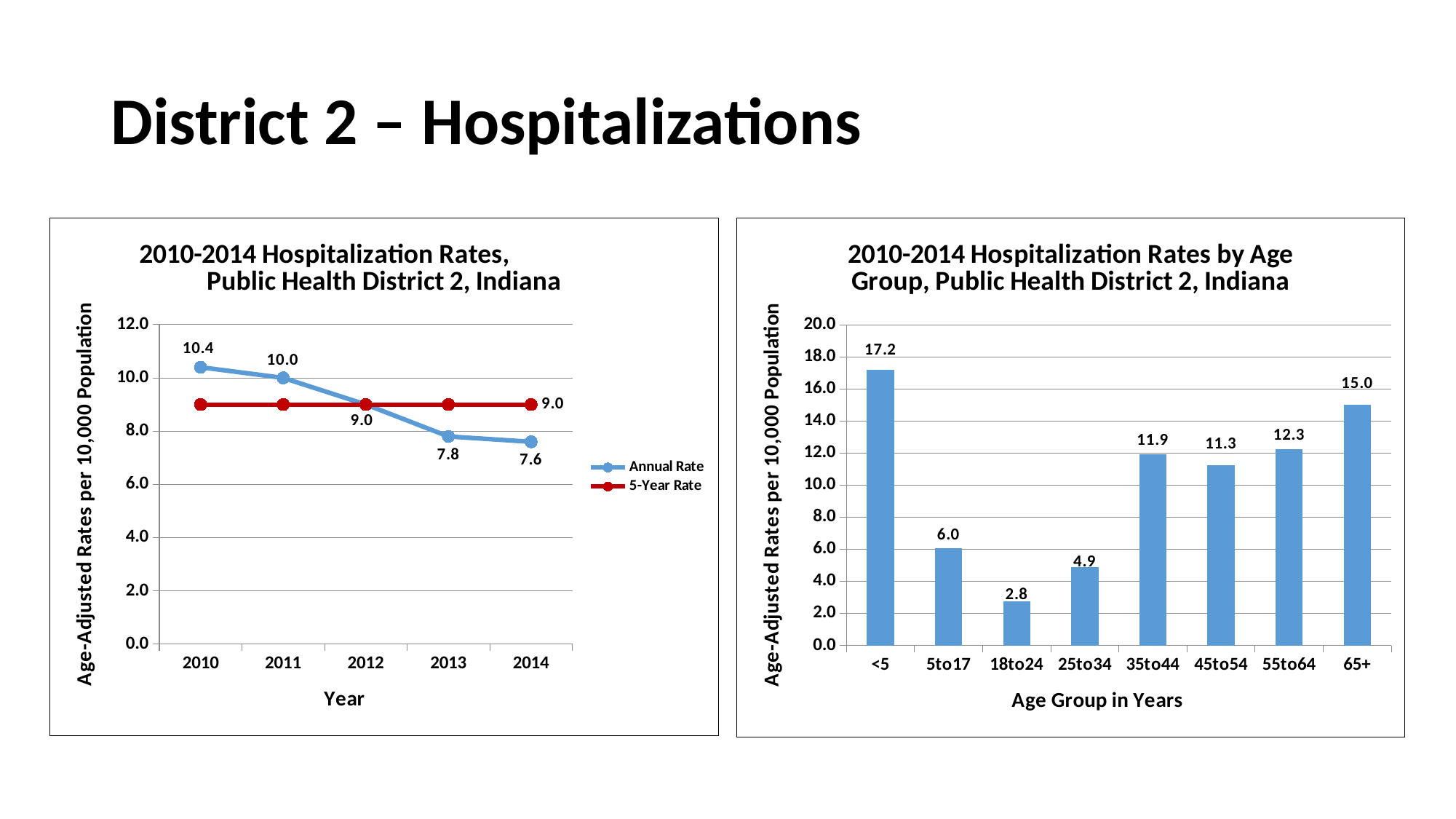
What kind of chart is the left chart (2010-2014 Hospitalization Rates, Public Health District 2, Indiana)? line chart In the left chart (2010-2014 Hospitalization Rates, Public Health District 2, Indiana), what is the difference between the Annual Rate in 2010 and in 2014? 2.8 In the right chart (2010-2014 Hospitalization Rates by Age Group), how many age groups are shown? 8 In the left chart (2010-2014 Hospitalization Rates, Public Health District 2, Indiana), what is the Annual Rate for 2010? 10.4 In the right chart (2010-2014 Hospitalization Rates by Age Group), which age group has the lowest rate? 18to24 In the left chart (2010-2014 Hospitalization Rates, Public Health District 2, Indiana), does the Annual Rate rise or fall from 2010 to 2014? fall In the left chart (2010-2014 Hospitalization Rates, Public Health District 2, Indiana), what is the Annual Rate for 2014? 7.6 In the right chart (2010-2014 Hospitalization Rates by Age Group), which is larger, the rate for 35to44 or the rate for 45to54? 35to44 In the left chart (2010-2014 Hospitalization Rates, Public Health District 2, Indiana), what is the 5-Year Rate? 9.0 In the right chart (2010-2014 Hospitalization Rates by Age Group), what is the rate for the 65+ age group? 15.0 In the right chart (2010-2014 Hospitalization Rates by Age Group), which age group has the highest rate? <5 In the left chart (2010-2014 Hospitalization Rates, Public Health District 2, Indiana), how many series does the legend list? 2